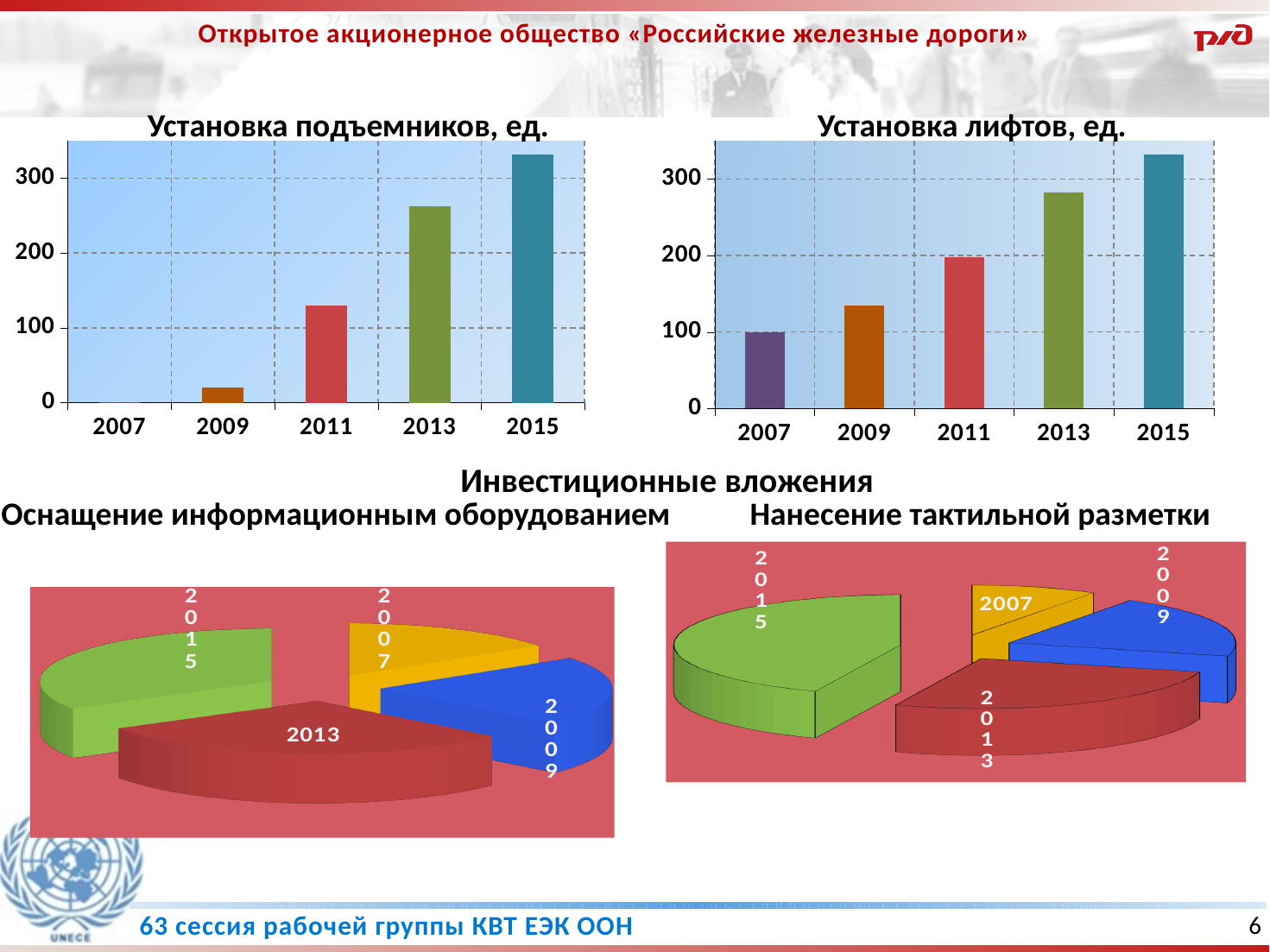
In the chart "Установка подъемников, ед.", do the values rise or fall from 2007 to 2015? rise In the chart "Установка лифтов, ед.", which is larger, the value for 2011 or the value for 2013? 2013 In the chart "Установка лифтов, ед.", which year has the highest value? 2015 In the chart "Установка лифтов, ед.", is the value for 2015 greater or less than 300? greater What kind of chart is "Установка подъемников, ед."? bar chart What kind of chart is "Оснащение информационным оборудованием"? pie chart In the pie chart "Нанесение тактильной разметки", how many slices are there? 4 In the chart "Установка подъемников, ед.", how many years are shown on the x axis? 5 In the chart "Установка подъемников, ед.", is the value for 2009 greater or less than 100? less In the chart "Установка подъемников, ед.", is the value for 2013 greater or less than 200? greater In the chart "Установка подъемников, ед.", which year has the lowest value? 2007